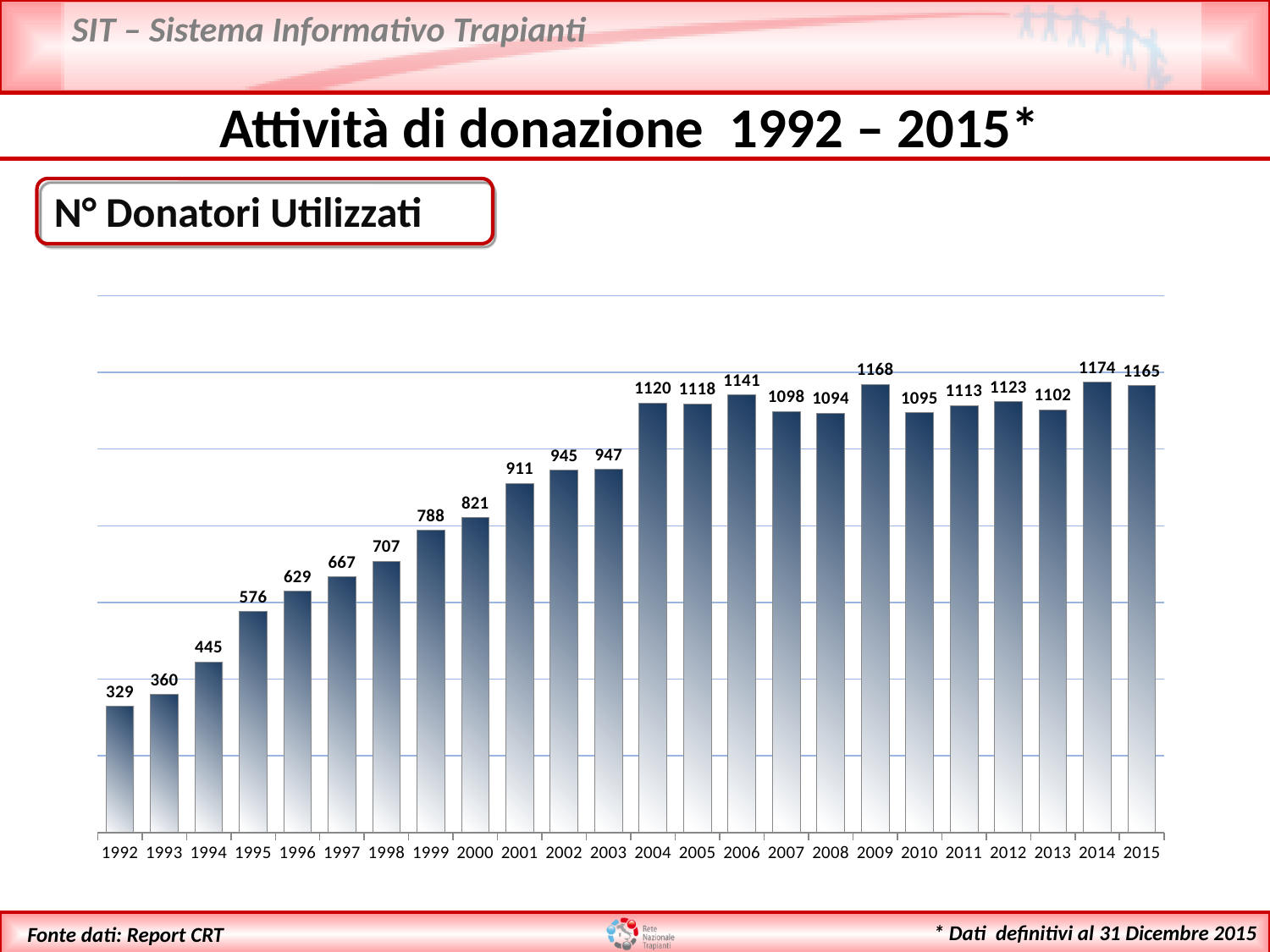
What is the value shown for 2015? 1165 Do the values generally rise or fall from 1992 to 2015? rise Which year has the highest value? 2014 Which year has the lowest value? 1992 What is the difference between the values for 2014 and 2015? 9 Which year has the larger value, 2009 or 2010? 2009 What is the value shown for 2004? 1120 What is the difference between the values for 2015 and 1992? 836 What is the value shown for 1999? 788 What is the number of donors used (N° Donatori Utilizzati) in 1992? 329 What type of chart is shown on the slide? bar chart How many years are shown on the x axis? 24